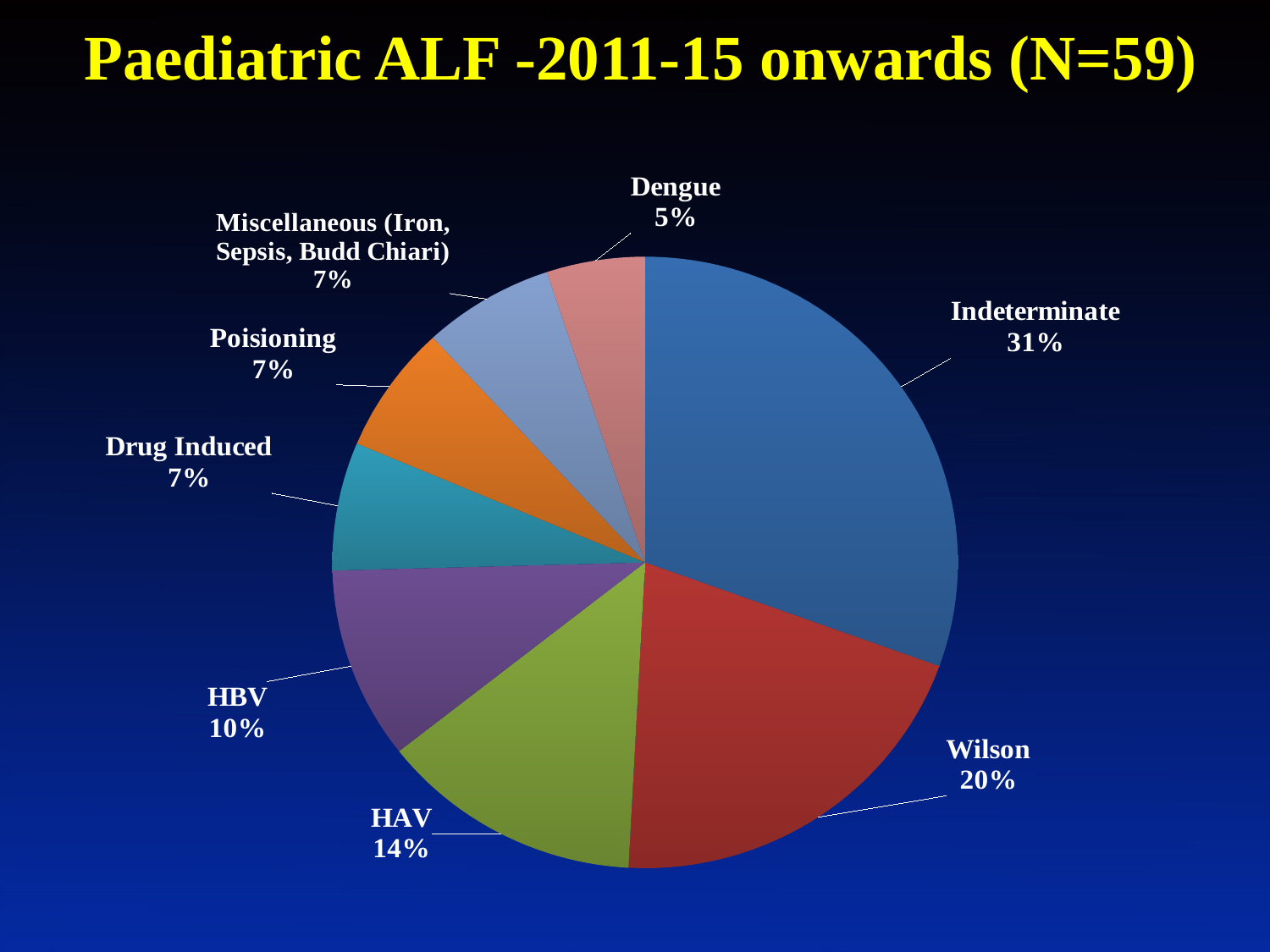
Which category has the smallest slice of the pie? Dengue What is the difference in percentage points between Indeterminate and Wilson? 11 Which category has the largest slice of the pie? Indeterminate What percentage of the pie is Indeterminate? 31% What is the title of the slide? Paediatric ALF -2011-15 onwards (N=59) How many categories are shown in the pie chart? 8 Which is larger, the HAV slice or the HBV slice? HAV What is the value shown for HAV? 14% What share does Wilson account for? 20% What kind of chart is shown on the slide? pie chart What is the value for Dengue? 5% What percentage is labelled for HBV? 10%